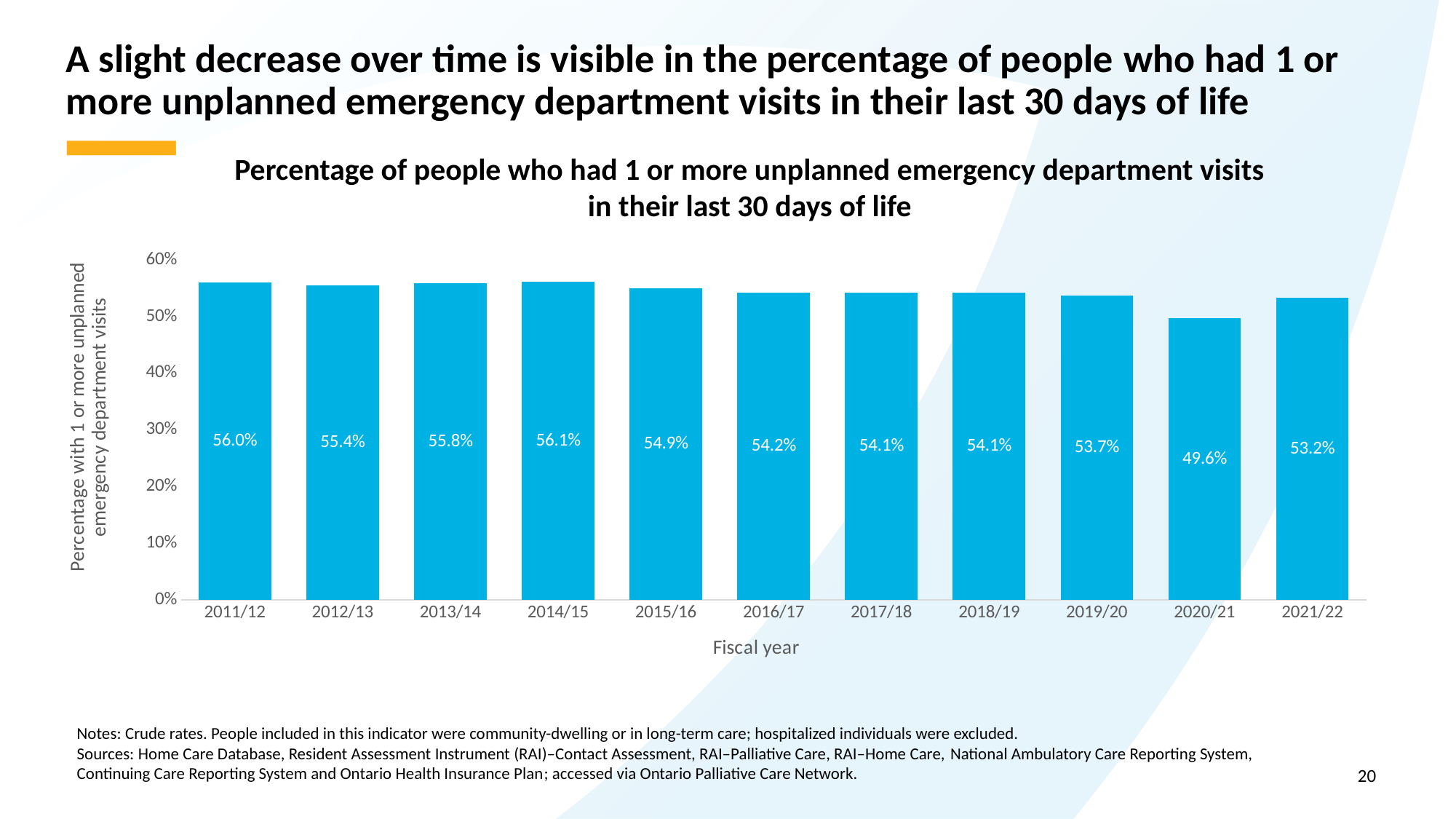
What is the value for 2016/17? 54.2% What kind of chart is shown on the slide? Bar chart Which is larger, the value for 2012/13 or the value for 2019/20? 2012/13 Which fiscal year has the highest percentage? 2014/15 What is the difference between the values for 2011/12 and 2020/21? 6.4 percentage points What is the value for 2021/22? 53.2% Which fiscal year has the lowest percentage? 2020/21 What is the value for 2011/12? 56.0% What is the label of the x axis? Fiscal year How many fiscal years are shown on the chart? 11 Is the value for 2020/21 greater or less than 50%? less What is the value for 2020/21? 49.6%